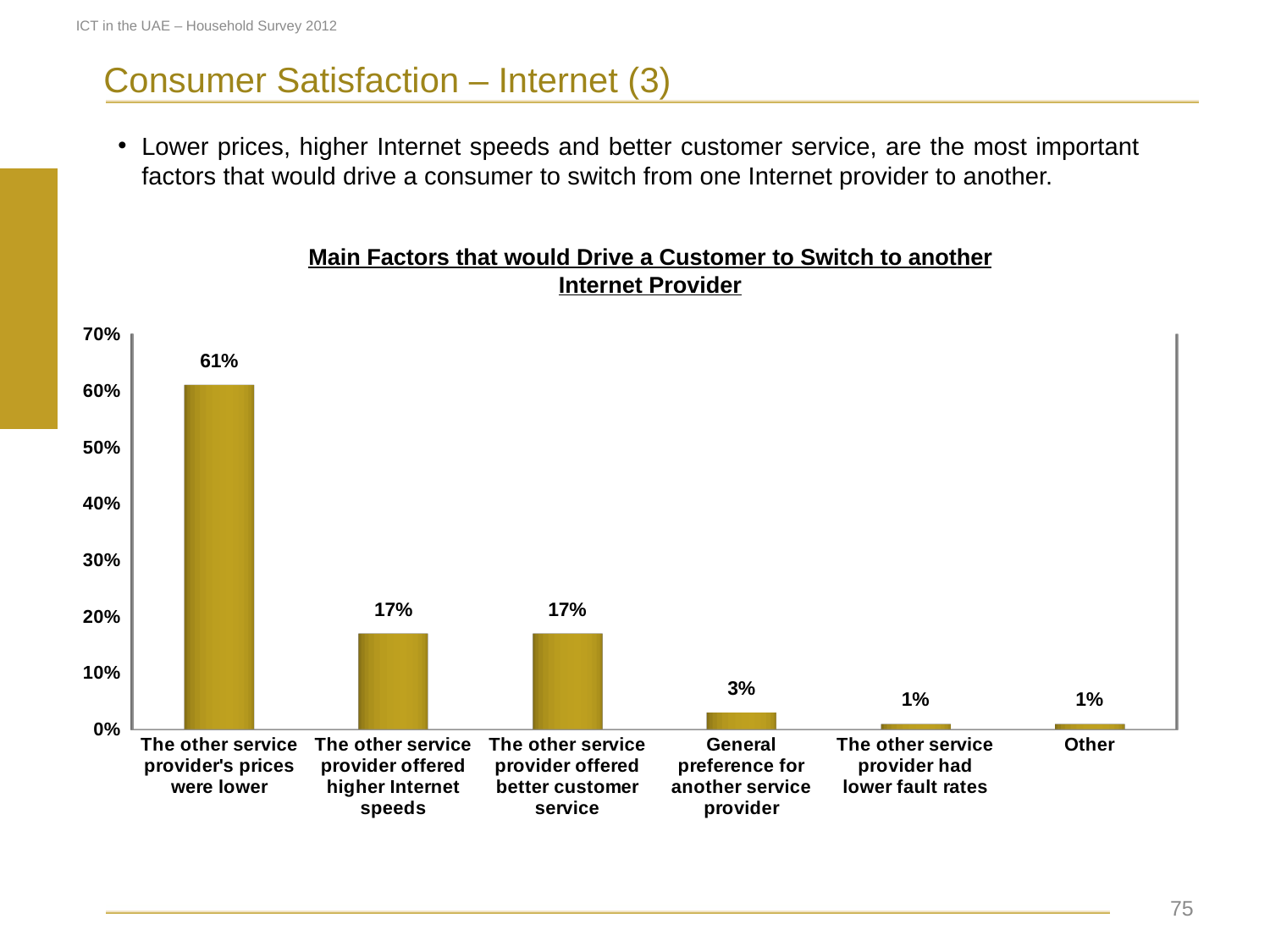
What is the value for 'The other service provider had lower fault rates'? 1% Which is larger: the value for 'General preference for another service provider' or the value for 'Other'? General preference for another service provider Which factor has the highest value in the chart? The other service provider's prices were lower What is the title of the chart? Main Factors that would Drive a Customer to Switch to another Internet Provider What kind of chart is shown on the slide? Bar chart What is the difference between the value for lower prices and the value for better customer service? 44% How many categories are shown on the x axis of the chart? 6 What is the value for 'General preference for another service provider'? 3% What percentage of respondents said they would switch because the other service provider's prices were lower? 61% Do the values generally rise or fall moving from left to right along the x axis? Fall What is the value for 'The other service provider offered higher Internet speeds'? 17% Is the value for 'The other service provider's prices were lower' greater or less than 50%? greater